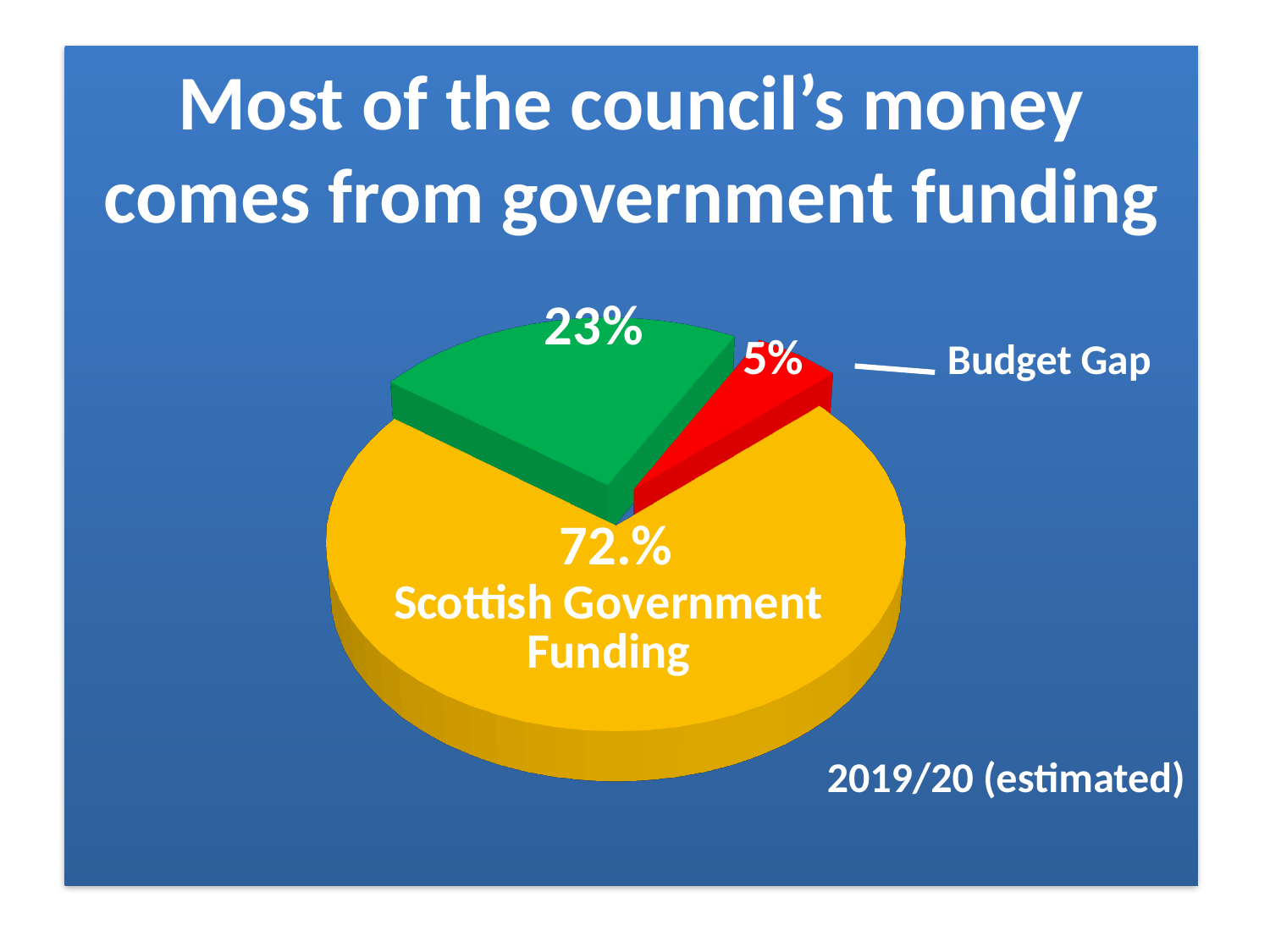
What share of the pie is Scottish Government Funding? 72.% Is the share for Scottish Government Funding greater or less than 50%? greater Which labelled slice of the pie is the smallest? Budget Gap What is the difference in percentage points between the green slice (23%) and the Budget Gap slice (5%)? 18 What percentage is shown for the Budget Gap slice? 5% Which is larger, the Budget Gap slice or the Scottish Government Funding slice? Scottish Government Funding What kind of chart is shown on the slide? Pie chart Which year does the pie chart refer to, according to the note on the slide? 2019/20 (estimated) Which slice of the pie is the largest? Scottish Government Funding What percentage is shown on the green slice of the pie? 23% How many slices does the pie chart have? 3 What is the title of the slide? Most of the council's money comes from government funding